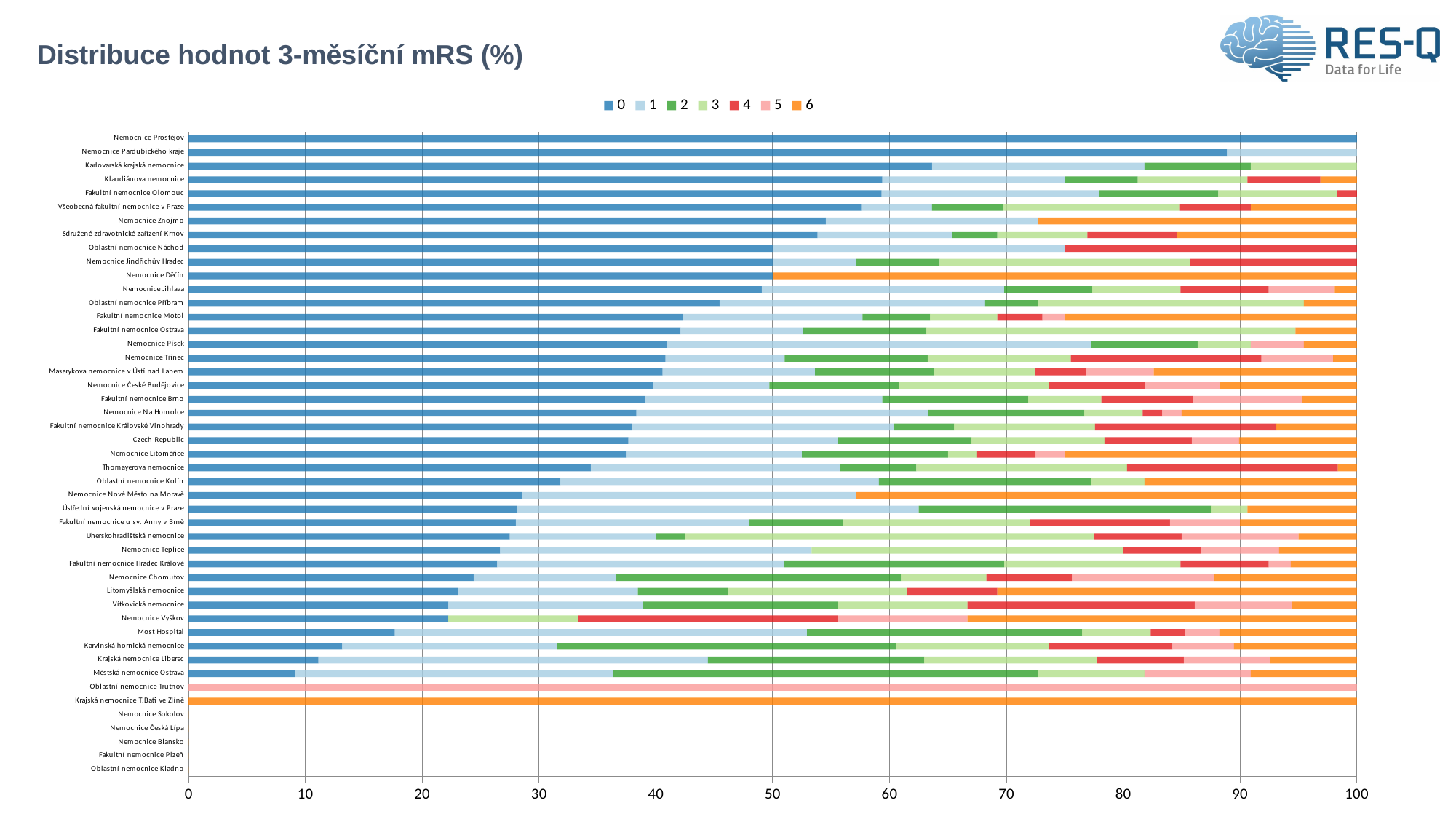
What is the value of series 0 for Nemocnice Prostějov? 100 Is the value of series 0 for Nemocnice Pardubického kraje greater or less than 80? greater What is the value of series 6 for Nemocnice Děčín? 50 What is the total of the stacked bar for Nemocnice Děčín? 100 What is the value of series 5 for Oblastní nemocnice Trutnov? 100 Which hospital has the highest value for series 6? Krajská nemocnice T.Bati ve Zlíně Which is larger: the series 0 value for Nemocnice Prostějov or for Most Hospital? Nemocnice Prostějov How many series does the legend list? 7 What kind of chart is shown on the slide? Stacked horizontal bar chart What is the title of the chart? Distribuce hodnot 3-měsíční mRS (%) How many hospitals listed on the y axis have no bar plotted at all? 5 Is the value of series 0 for Městská nemocnice Ostrava greater or less than 10? less